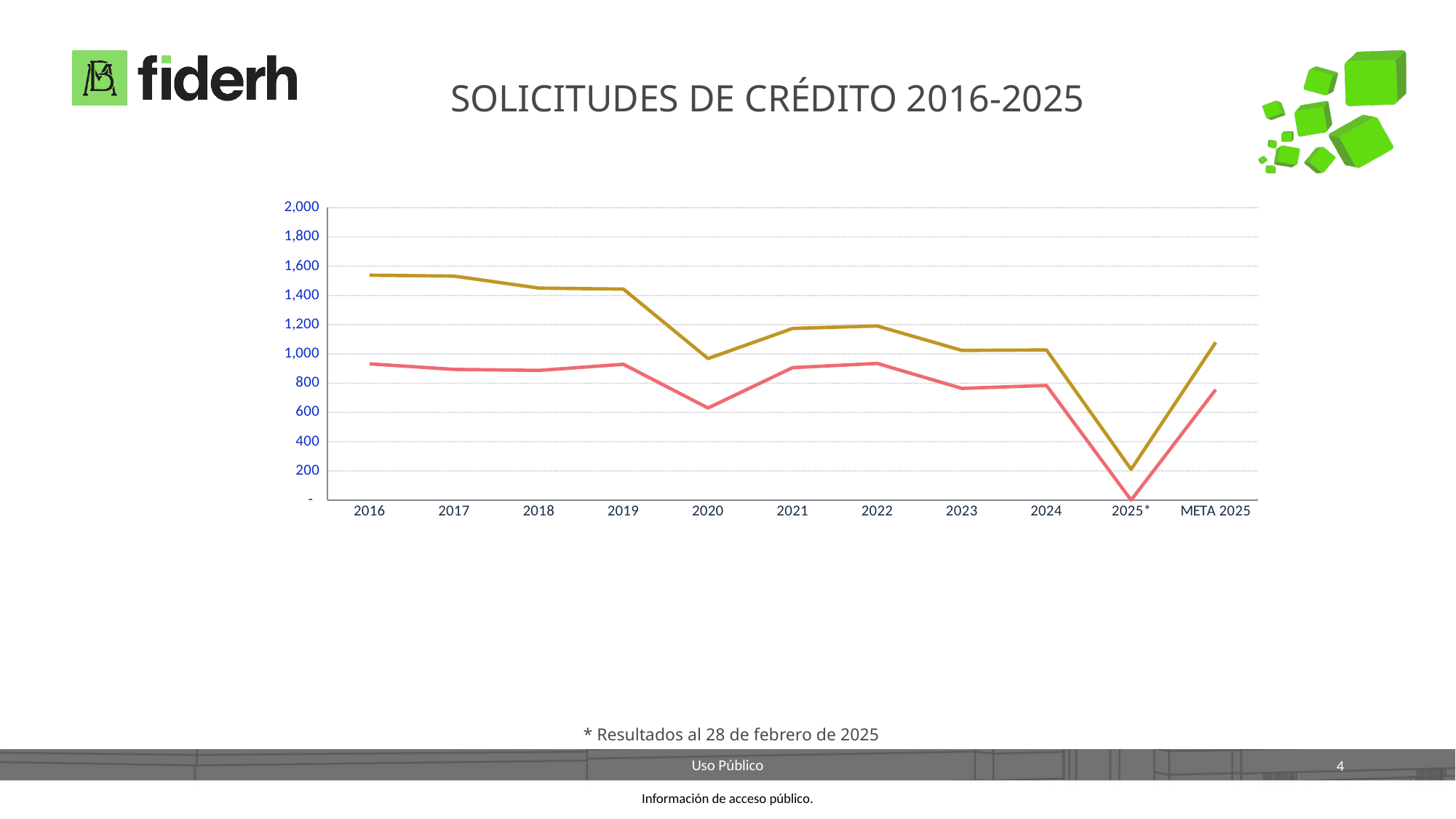
In 2020, which line has the larger value, the gold line or the pink line? gold line For which category is the gold line at its lowest value? 2025* How many categories are shown along the x axis? 11 Is the value of the gold line for 2020 greater or less than 1,000? less What kind of chart is shown on the slide? line chart Is the value of the gold line for 2016 greater or less than 1,400? greater Is the value of the pink line for 2020 greater or less than 800? less For which category is the pink line at its lowest value? 2025* What is the title of the chart? SOLICITUDES DE CRÉDITO 2016-2025 Does the gold line rise or fall from 2016 to 2020? fall